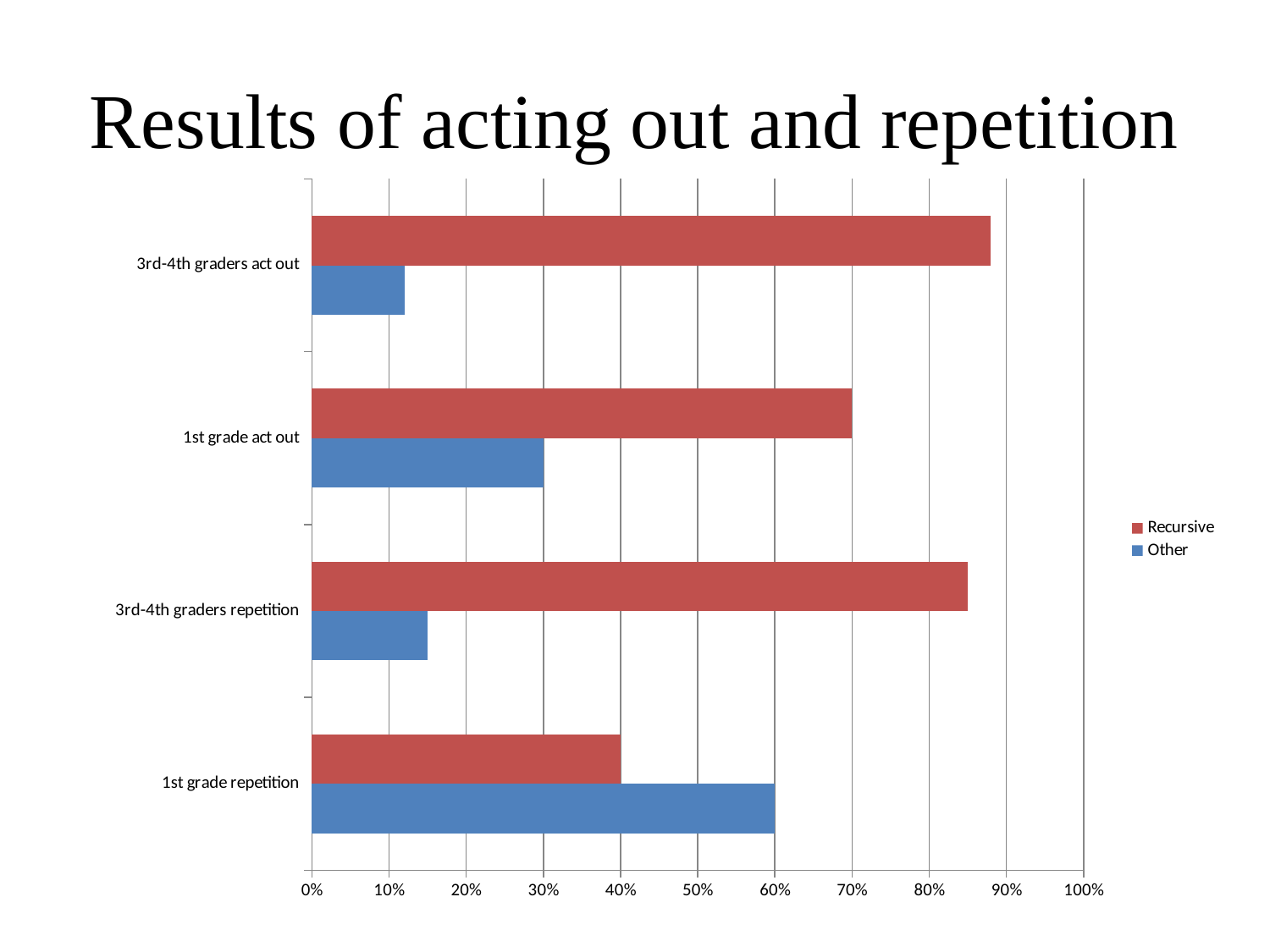
What is the difference between the Recursive and Other values for 1st grade act out? 40% How many series does the legend list? 2 What is the Other value for 1st grade repetition? 60% Which category has the lowest Recursive value? 1st grade repetition What is the Recursive value for 1st grade repetition? 40% For 1st grade repetition, which is larger, Recursive or Other? Other How many categories are shown on the chart? 4 Is the Other value for 3rd-4th graders repetition greater or less than 20%? less What type of chart is shown on the slide? bar chart Which category has the highest Recursive value? 3rd-4th graders act out Is the Recursive value for 3rd-4th graders act out greater or less than 80%? greater What is the Recursive value for 1st grade act out? 70%